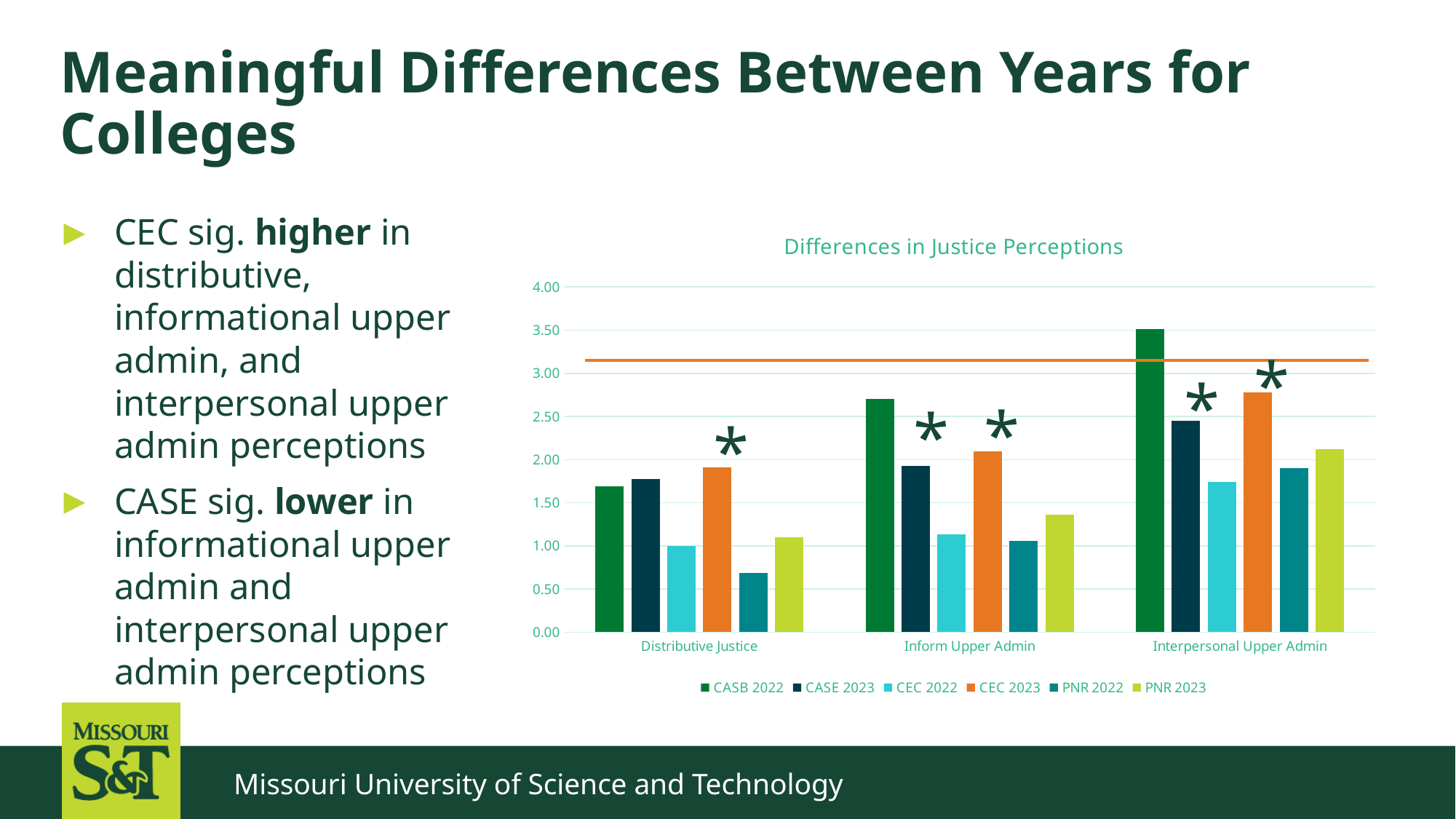
Is the value for PNR 2022 in Distributive Justice greater or less than 1.00? less In which category is the CASB 2022 bar the highest? Interpersonal Upper Admin Do the CASB 2022 values rise or fall from Distributive Justice to Interpersonal Upper Admin? rise What is the title of the chart? Differences in Justice Perceptions In the Inform Upper Admin category, which is larger: CASB 2022 or CASE 2023? CASB 2022 Which series has the lowest bar in the Distributive Justice category? PNR 2022 What kind of chart is shown on the slide? bar chart Is the value for CEC 2023 in Distributive Justice greater or less than 1.50? greater Is the value for CASB 2022 in Interpersonal Upper Admin greater or less than 3.00? greater How many categories are shown on the x axis of the chart? 3 How many series does the legend of the chart list? 6 Which series has the highest bar in the Inform Upper Admin category? CASB 2022